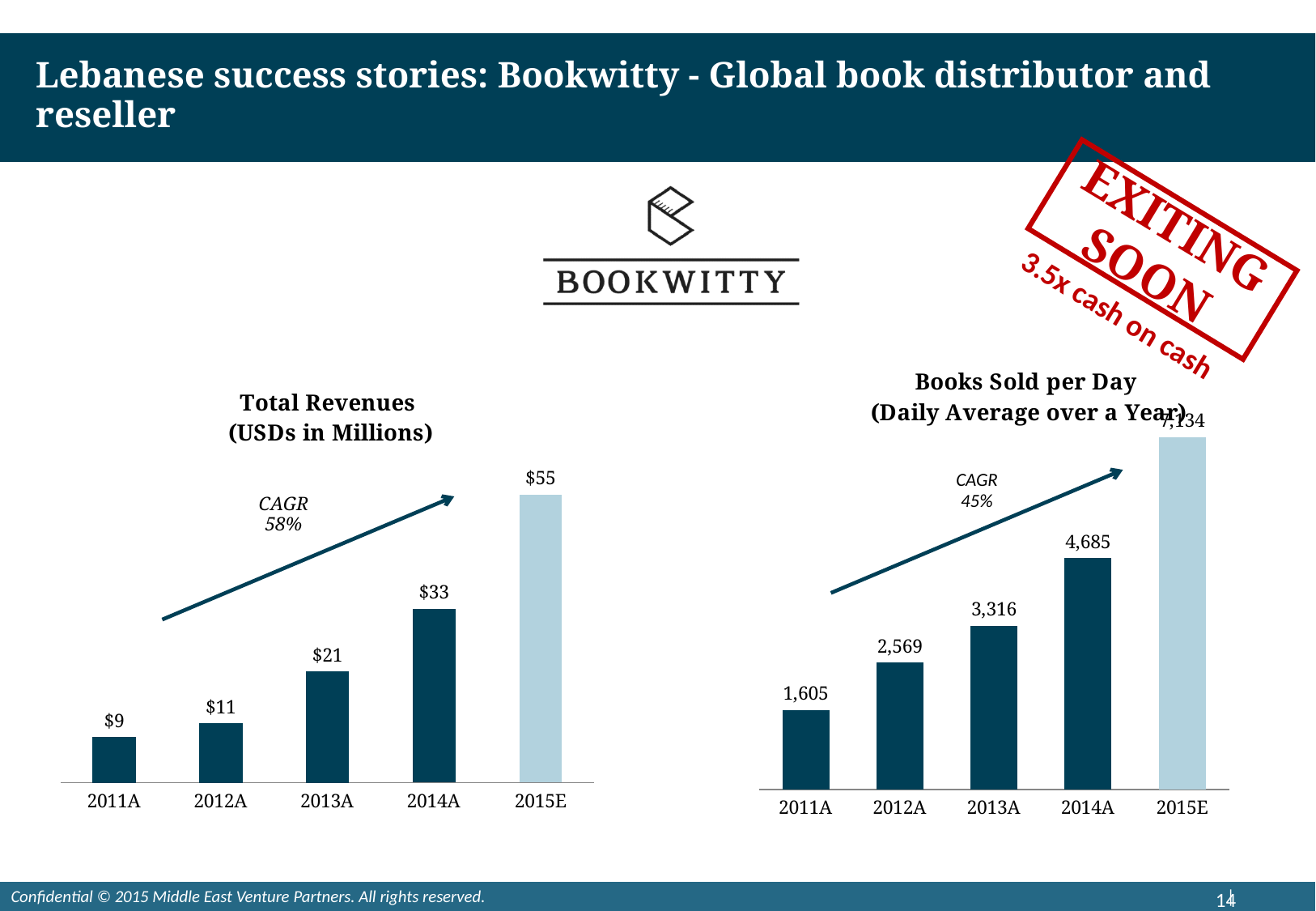
In the Total Revenues chart, do the values rise or fall from 2011A to 2015E? rise In the Total Revenues chart, how many years are shown on the x axis? 5 In the Books Sold per Day chart, what is the value for 2011A? 1,605 In the Books Sold per Day chart, which is larger, 2012A or 2013A? 2013A In the Total Revenues chart, what is the value for 2014A? $33 In the Total Revenues chart, what is the difference between 2015E and 2014A? $22 In the Total Revenues chart, which year has the highest value? 2015E In the Books Sold per Day chart, what is the value for 2013A? 3,316 In the Books Sold per Day chart, which year has the lowest value? 2011A What kind of chart is the Total Revenues chart? bar chart In the Books Sold per Day chart, what is the difference between 2014A and 2013A? 1,369 In the Total Revenues chart, what is the value for 2011A? $9